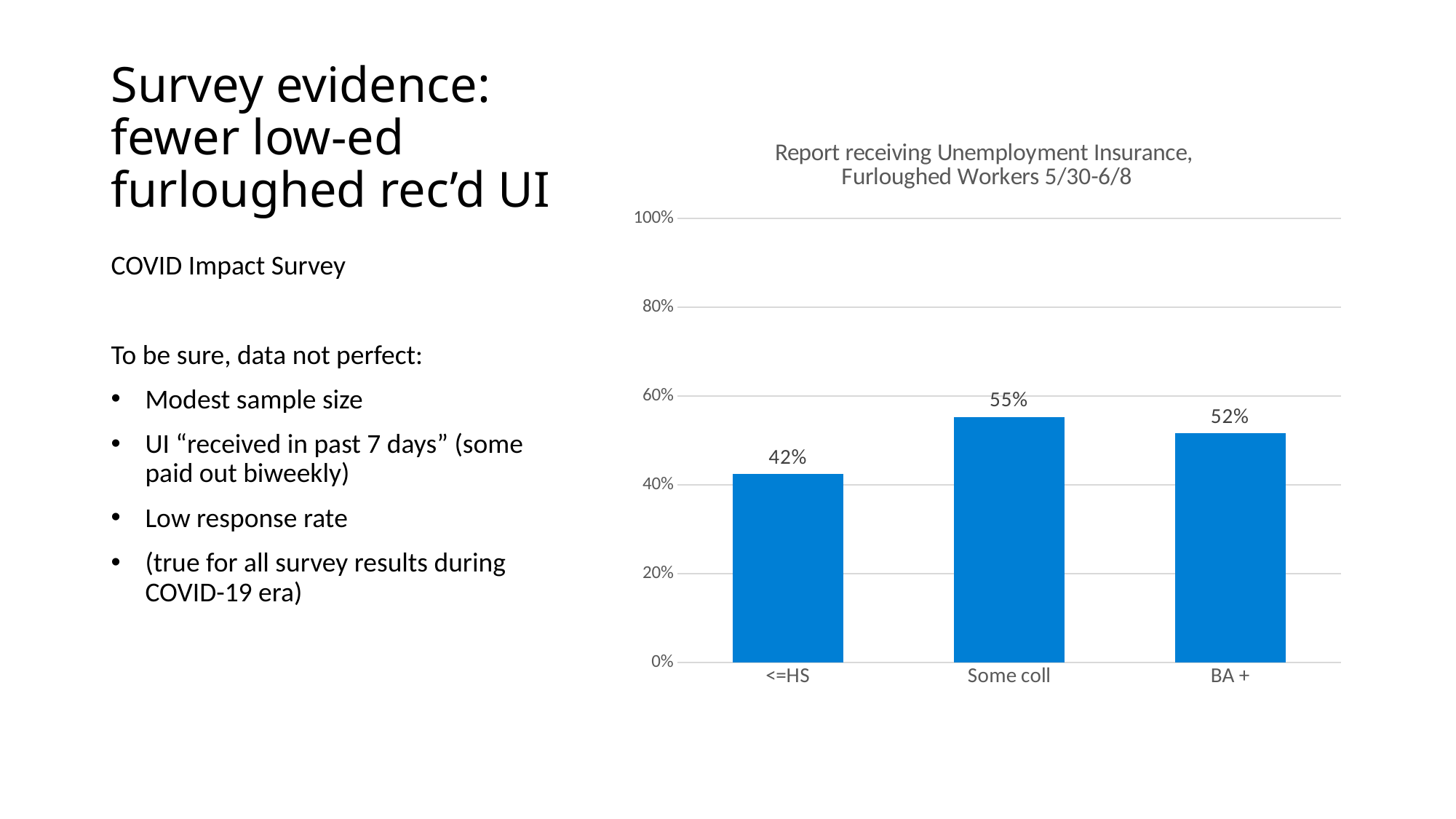
What is the title of the chart? Report receiving Unemployment Insurance, Furloughed Workers 5/30-6/8 Which education category has the lowest share reporting receipt of Unemployment Insurance? <=HS Which education category has the highest share reporting receipt of Unemployment Insurance? Some coll What type of chart is shown on the slide? Bar chart What is the value shown for the Some coll category? 55% What percentage of furloughed workers with <=HS education report receiving Unemployment Insurance? 42% Is the value for <=HS greater or less than 40%? greater What is the difference in percentage points between the Some coll and <=HS categories? 13 percentage points Which is larger, the value for Some coll or the value for BA +? Some coll What is the value shown for the BA + category? 52% How many education categories are shown in the chart? 3 What is the difference in percentage points between the BA + and <=HS categories? 10 percentage points